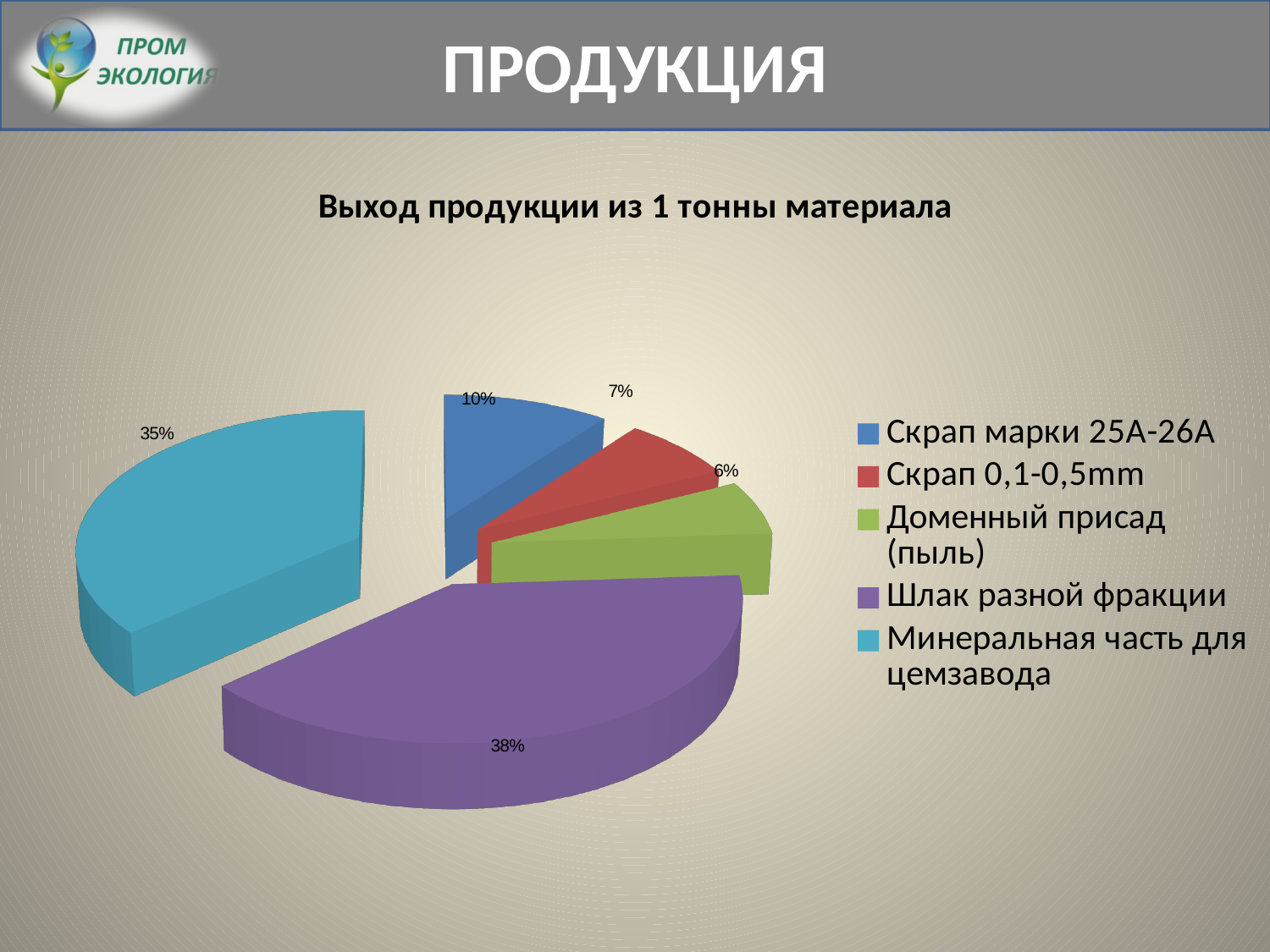
What is the difference in percentage points between Шлак разной фракции and Минеральная часть для цемзавода? 3 What share of the pie is Минеральная часть для цемзавода? 35% Which category has the largest share of the pie? Шлак разной фракции How many slices does the pie chart have? 5 Which category has the smallest share of the pie? Доменный присад (пыль) What share of the pie is Скрап 0,1-0,5mm? 7% What share of the pie is Шлак разной фракции? 38% What is the title of the chart? Выход продукции из 1 тонны материала Which colour represents Минеральная часть для цемзавода in the legend? Light blue (cyan) What type of chart is shown on the slide? Pie chart